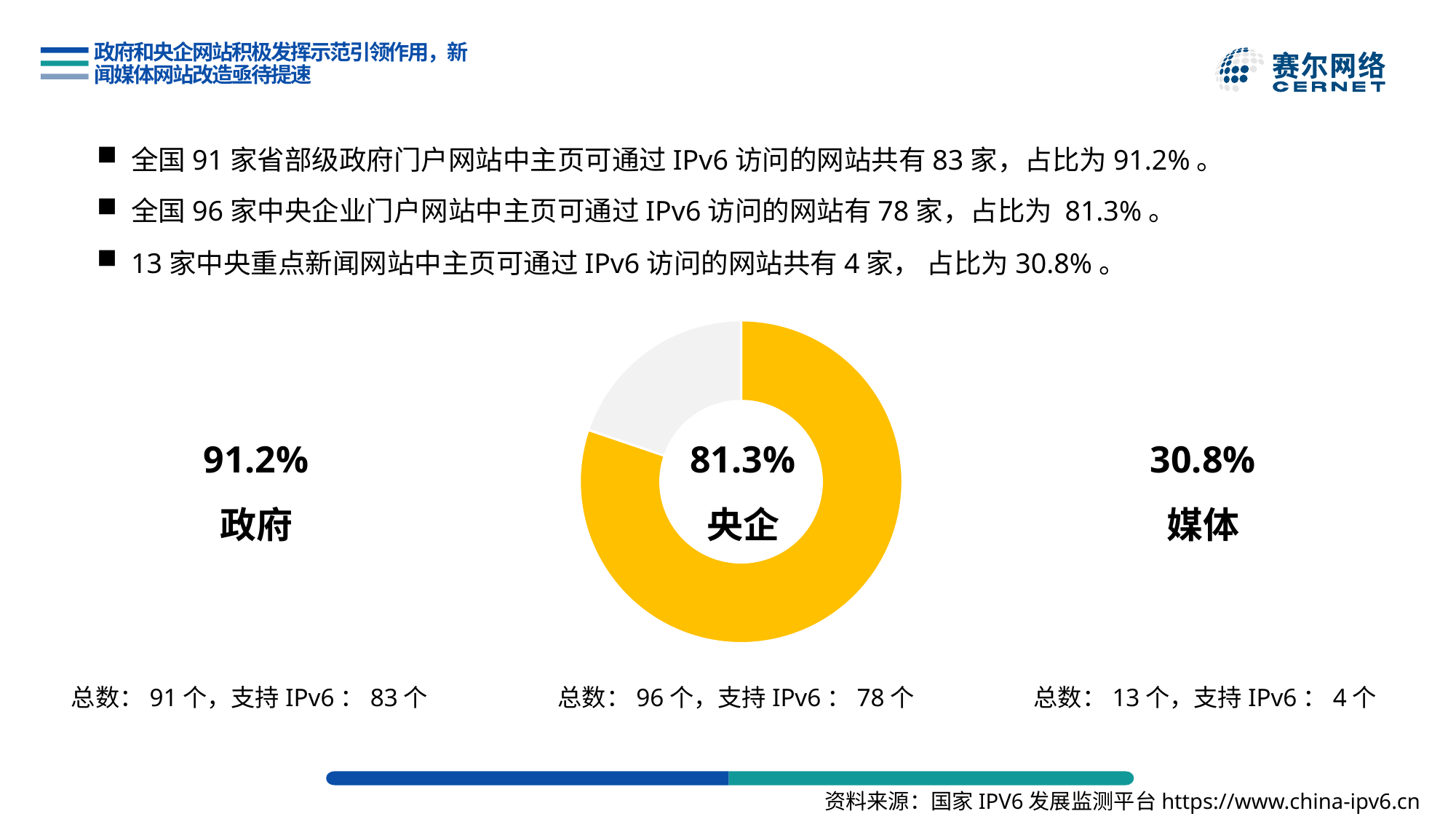
How many segments does the donut chart have? 2 According to the text below the donut chart, how many 央企 websites support IPv6? 78 个 Which category does the donut chart represent? 央企 What is the difference between the 政府 percentage (91.2%) and the 央企 percentage shown in the donut chart (81.3%)? 9.9% Of the three percentages shown on the slide (政府, 央企, 媒体), which is the lowest? 媒体 (30.8%) What kind of chart is shown in the centre of the slide? Donut chart Is the yellow segment of the donut chart greater or less than 50% of the ring? greater According to the text below the donut chart, what is the total number (总数) of 央企 websites? 96 个 What colour is the larger segment of the donut chart? Yellow Which is larger, the 央企 percentage shown in the donut chart (81.3%) or the 政府 percentage shown on the left (91.2%)? 政府 (91.2%) What percentage is printed in the centre of the donut chart? 81.3% What share of the donut chart is filled by the yellow segment? 81.3%